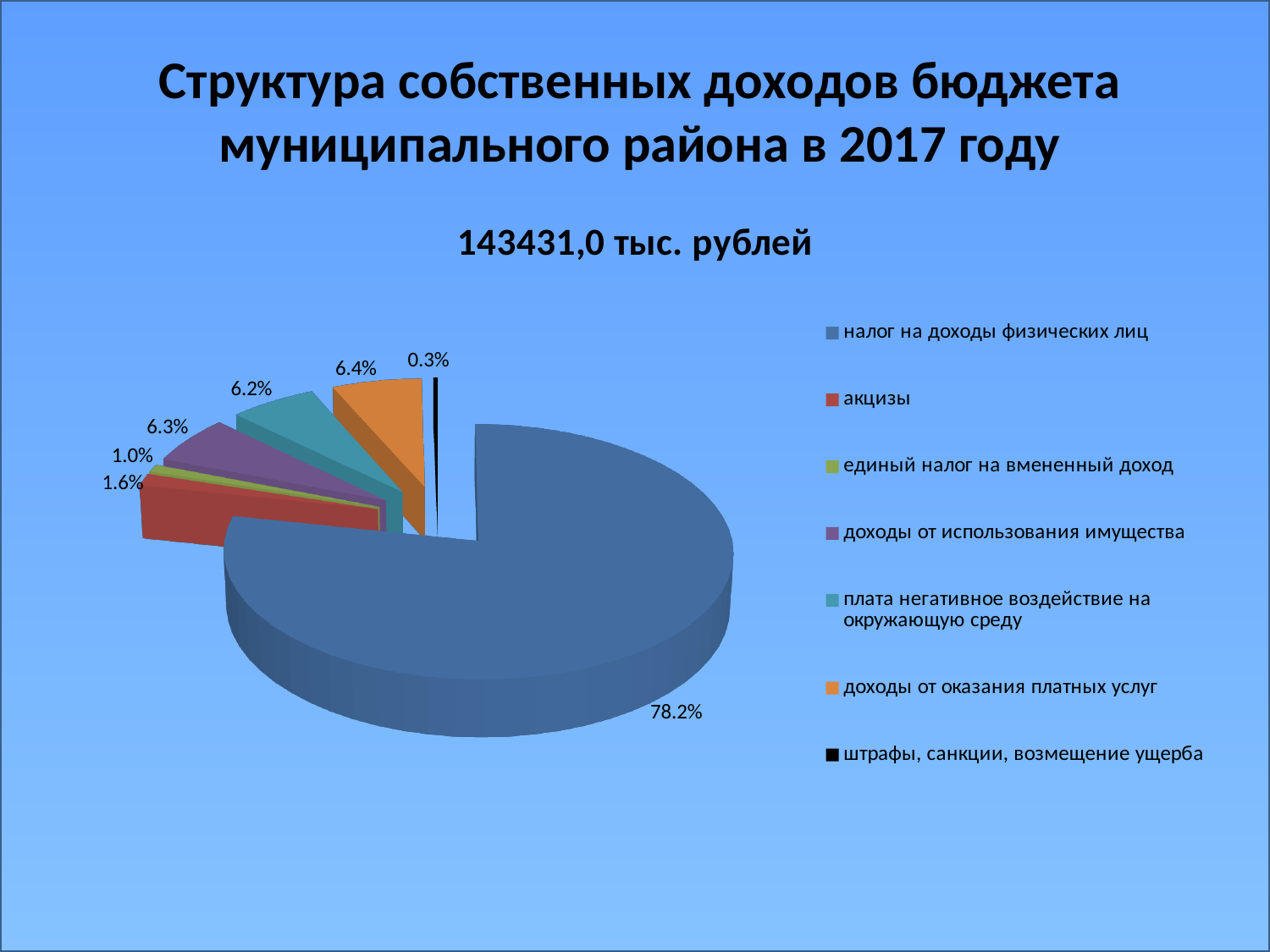
What is the value shown for штрафы, санкции, возмещение ущерба? 0.3% Which category has the largest share of the pie? налог на доходы физических лиц What is the difference between the shares of доходы от оказания платных услуг and плата негативное воздействие на окружающую среду? 0.2% What kind of chart is shown on the slide? pie chart What share of the pie does налог на доходы физических лиц account for? 78.2% What is the value shown for доходы от использования имущества? 6.3% How many categories does the legend list? 7 Which category has the smallest share of the pie? штрафы, санкции, возмещение ущерба Which is larger: the share of акцизы or the share of единый налог на вмененный доход? акцизы What is the value shown for доходы от оказания платных услуг? 6.4% What is the value shown for акцизы? 1.6% What total amount is stated above the chart? 143431,0 тыс. рублей